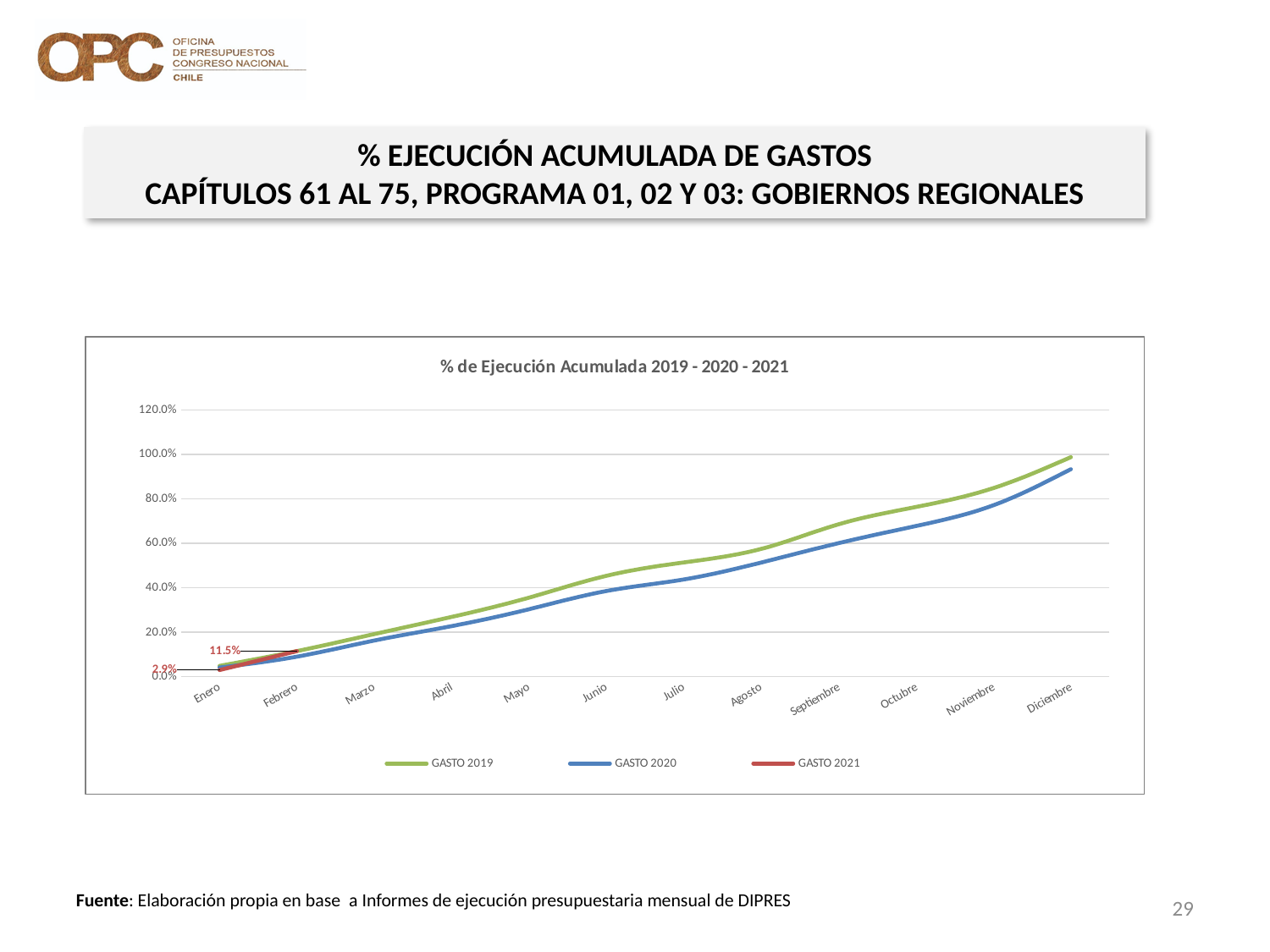
What kind of chart is shown on the slide? line chart What is the value for GASTO 2021 in Febrero? 11.5% What is the value for GASTO 2021 in Enero? 2.9% In Diciembre, which series is higher, GASTO 2019 or GASTO 2020? GASTO 2019 Is the value for GASTO 2019 in Diciembre greater or less than 80.0%? greater Do the GASTO 2019 and GASTO 2020 lines rise or fall from Enero to Diciembre? rise Is the value for GASTO 2019 in Septiembre greater or less than 60.0%? greater What is the title of the chart? % de Ejecución Acumulada 2019 - 2020 - 2021 Is the value for GASTO 2020 in Junio greater or less than 60.0%? less How many series does the legend list? 3 How many months are shown along the x axis? 12 By how many percentage points did GASTO 2021 increase from Enero to Febrero? 8.6 percentage points